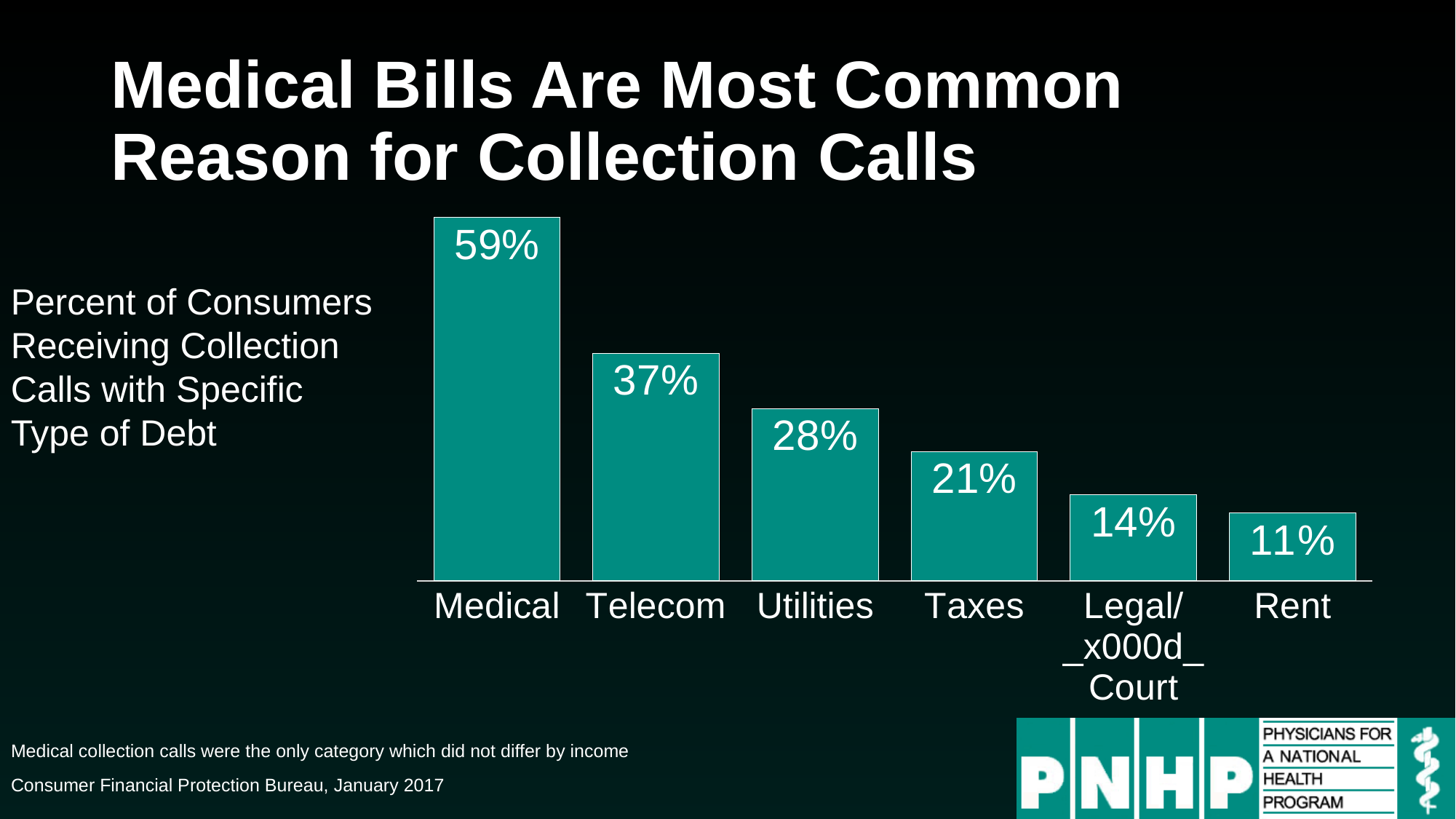
Which type of debt has the lowest percent of consumers receiving collection calls? Rent What is the value shown for Utilities? 28% Do the values rise or fall moving from left to right across the categories? Fall What is the value shown for Rent? 11% Which type of debt has the highest percent of consumers receiving collection calls? Medical How many types of debt are shown in the chart? 6 What is the difference between the Medical and Telecom values? 22% Which is larger, the value for Utilities or the value for Taxes? Utilities What is the difference between the Taxes and Legal/Court values? 7% What percent of consumers received collection calls for Medical debt? 59% What is the value shown for Telecom? 37% What kind of chart is shown on the slide? Bar chart